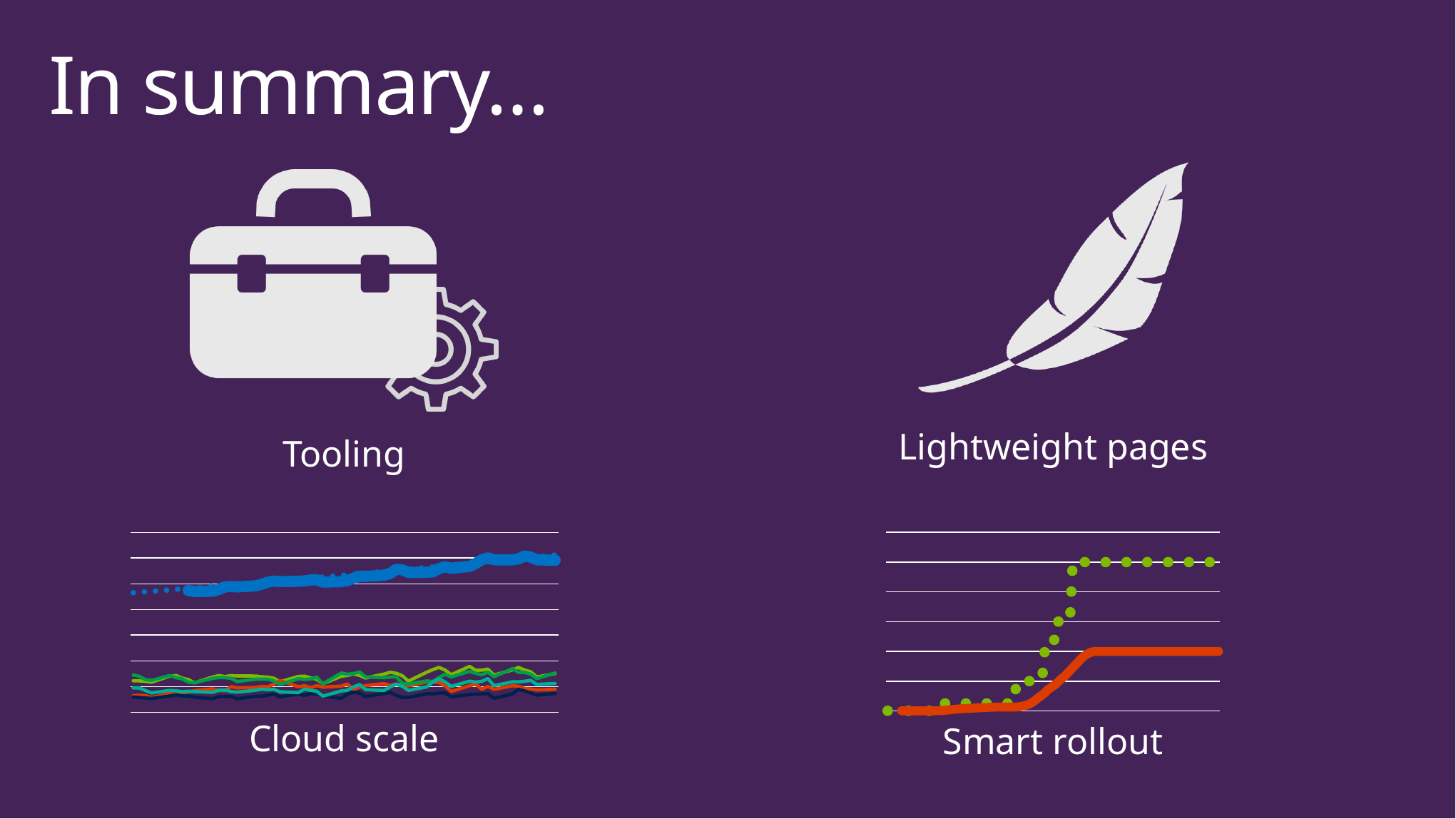
In the "Smart rollout" chart, which line ends higher at the right side: the green dotted line or the red line? the green dotted line What kind of chart is the chart labelled "Smart rollout"? line chart How many lines are plotted in the "Smart rollout" chart? 2 What is the label under the chart on the left side of the slide? Cloud scale In the "Smart rollout" chart, does the red line rise or fall from left to right? rise What is the label under the chart on the right side of the slide? Smart rollout What kind of chart is the chart labelled "Cloud scale"? line chart In the "Smart rollout" chart, does the green dotted line rise or fall from left to right? rise In the "Cloud scale" chart, which line is higher on the chart: the blue line or the red line? the blue line In the "Cloud scale" chart, does the blue line rise or fall from left to right? rise